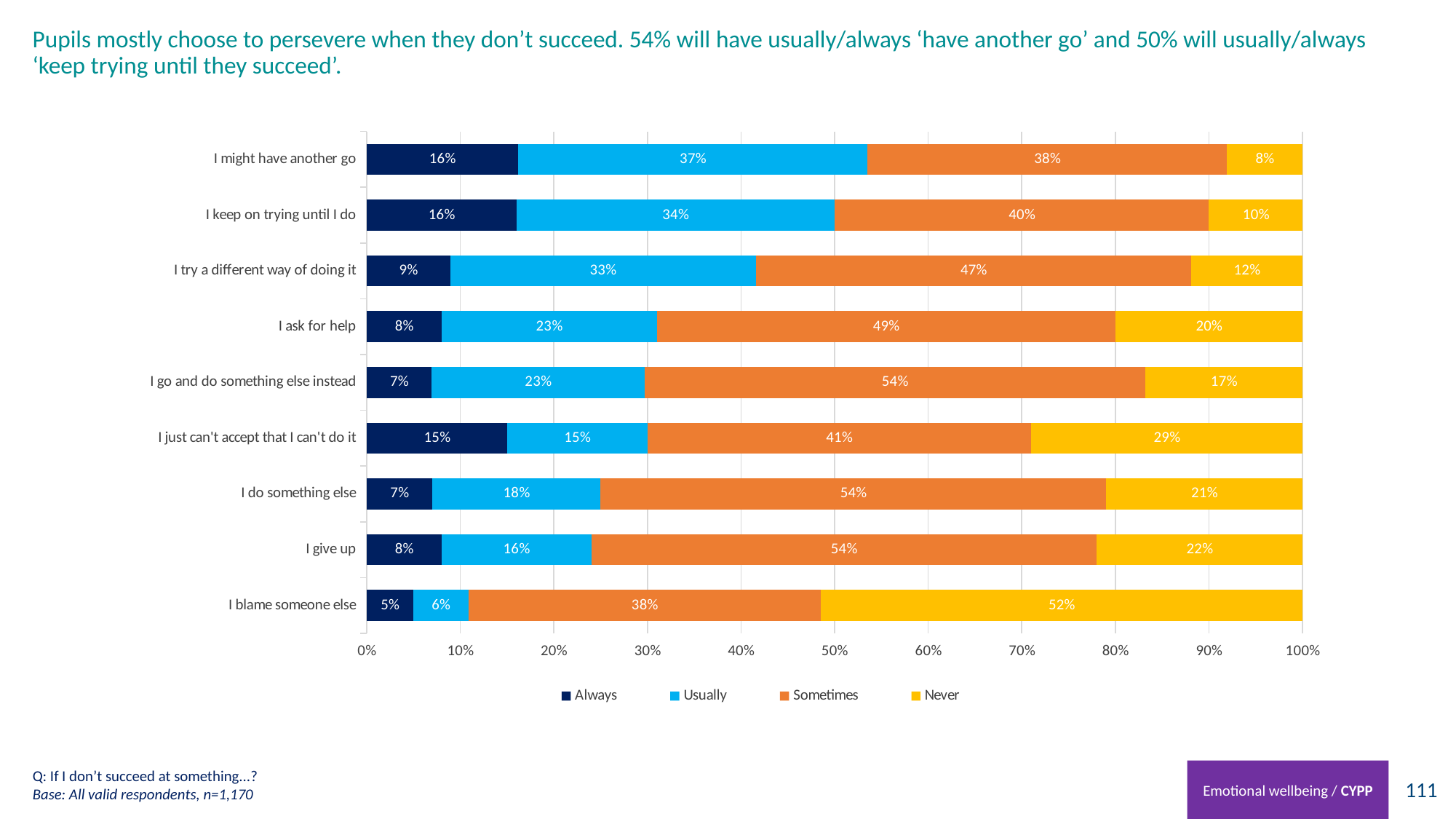
What percentage of pupils say they 'Always' 'might have another go'? 16% What is the 'Sometimes' value for 'I ask for help'? 49% What kind of chart is shown on the slide? Stacked bar chart Which is larger: the 'Sometimes' value for 'I go and do something else instead' or for 'I keep on trying until I do'? I go and do something else instead What is the 'Never' value for 'I blame someone else'? 52% How many series does the legend list? 4 Which category has the highest 'Never' value? I blame someone else Which category has the lowest 'Usually' value? I blame someone else What is the difference between the 'Never' values for 'I just can't accept that I can't do it' and 'I give up'? 7% What is the 'Usually' value for 'I try a different way of doing it'? 33% How many categories are shown on the chart? 9 What is the combined 'Always' and 'Usually' share for 'I might have another go'? 53%